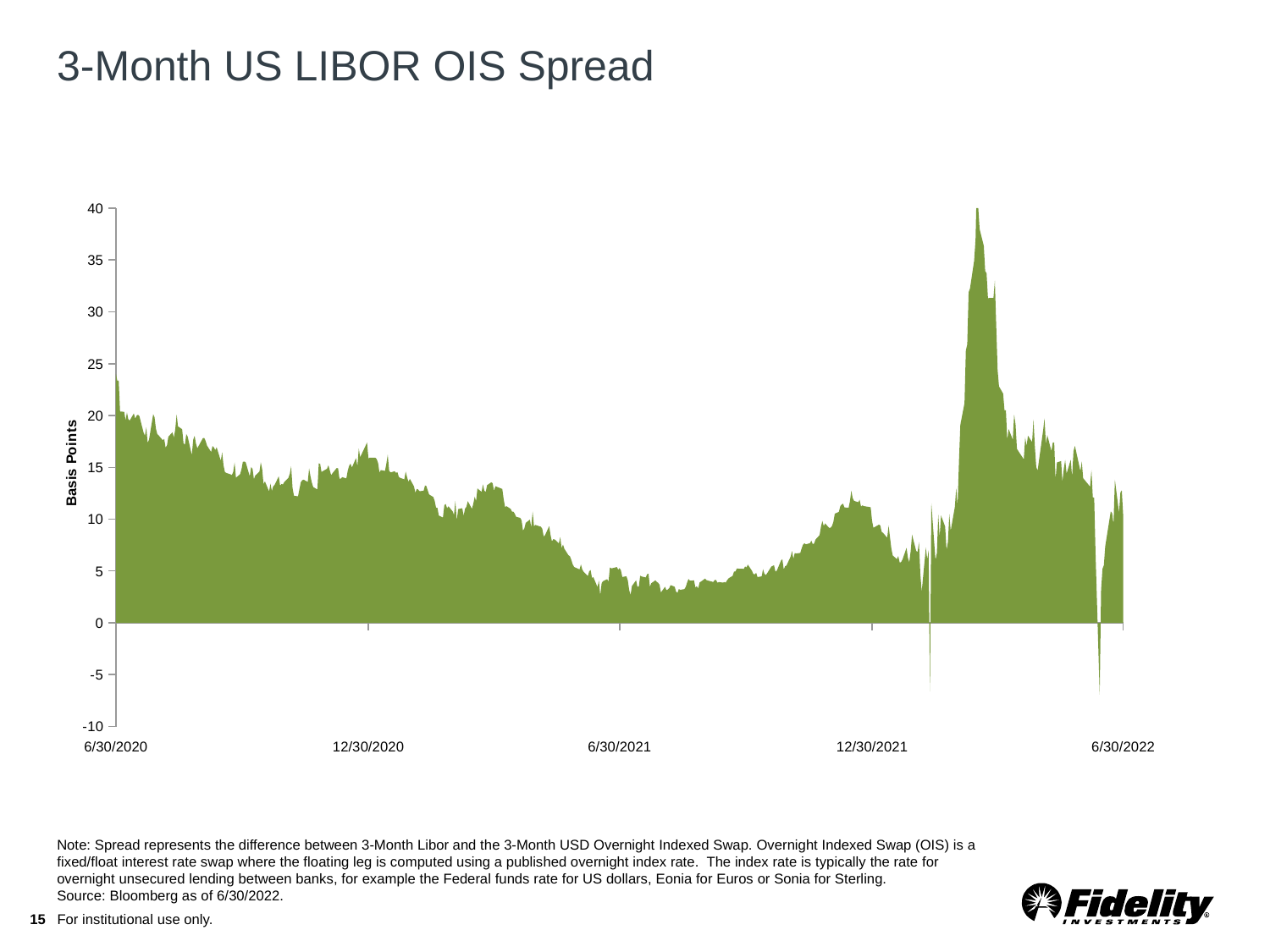
Between which two labelled dates on the x axis does the spread reach its highest peak? 12/30/2021 and 6/30/2022 How many dates are labelled on the x axis? 5 What is the title of the chart? 3-Month US LIBOR OIS Spread Is the value of the spread at 6/30/2020 greater or less than 15 basis points? greater What is the label on the vertical axis of the chart? Basis Points What kind of chart is shown on the slide? Area chart Is the highest peak of the spread greater or less than 35 basis points? greater What is the highest value shown on the vertical axis? 40 Is the value of the spread at 12/30/2020 greater or less than 10 basis points? greater Does the spread generally rise or fall between 6/30/2020 and 6/30/2021? fall